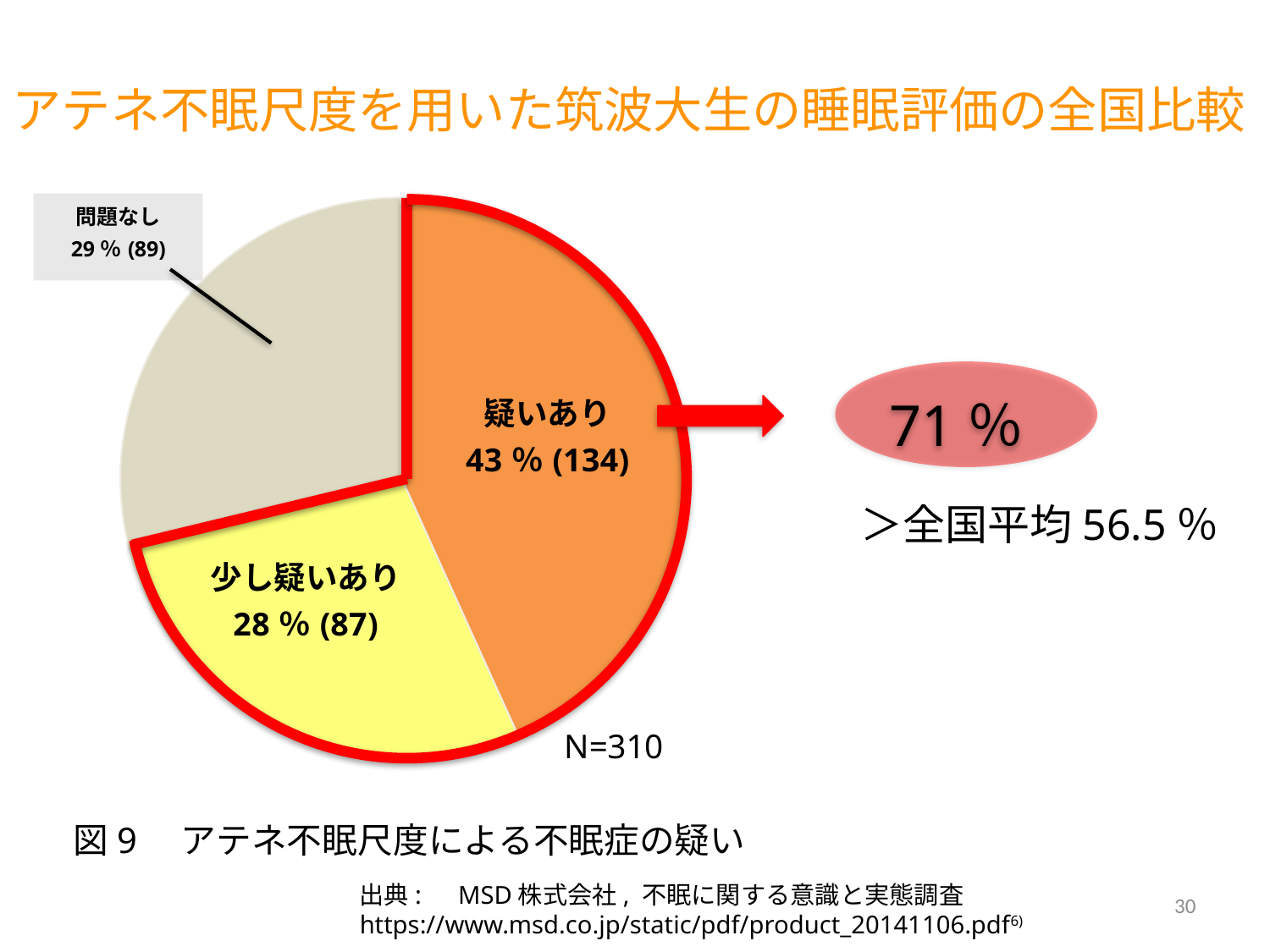
Which slice has a larger count, 問題なし or 少し疑いあり? 問題なし What is the combined percentage of the 疑いあり and 少し疑いあり slices? 71 % Which slice of the pie chart is the smallest? 少し疑いあり What is the total N shown for the pie chart? N=310 What percentage is shown for the 疑いあり slice? 43 % Which slice of the pie chart is the largest? 疑いあり What count is shown in parentheses for the 少し疑いあり slice? 87 What national average percentage is shown next to the pie chart for comparison? 56.5 % What kind of chart is shown on the slide? pie chart How many slices does the pie chart have? 3 What percentage is shown for the 問題なし slice? 29 % What is the difference in count between the 疑いあり slice (134) and the 問題なし slice (89)? 45